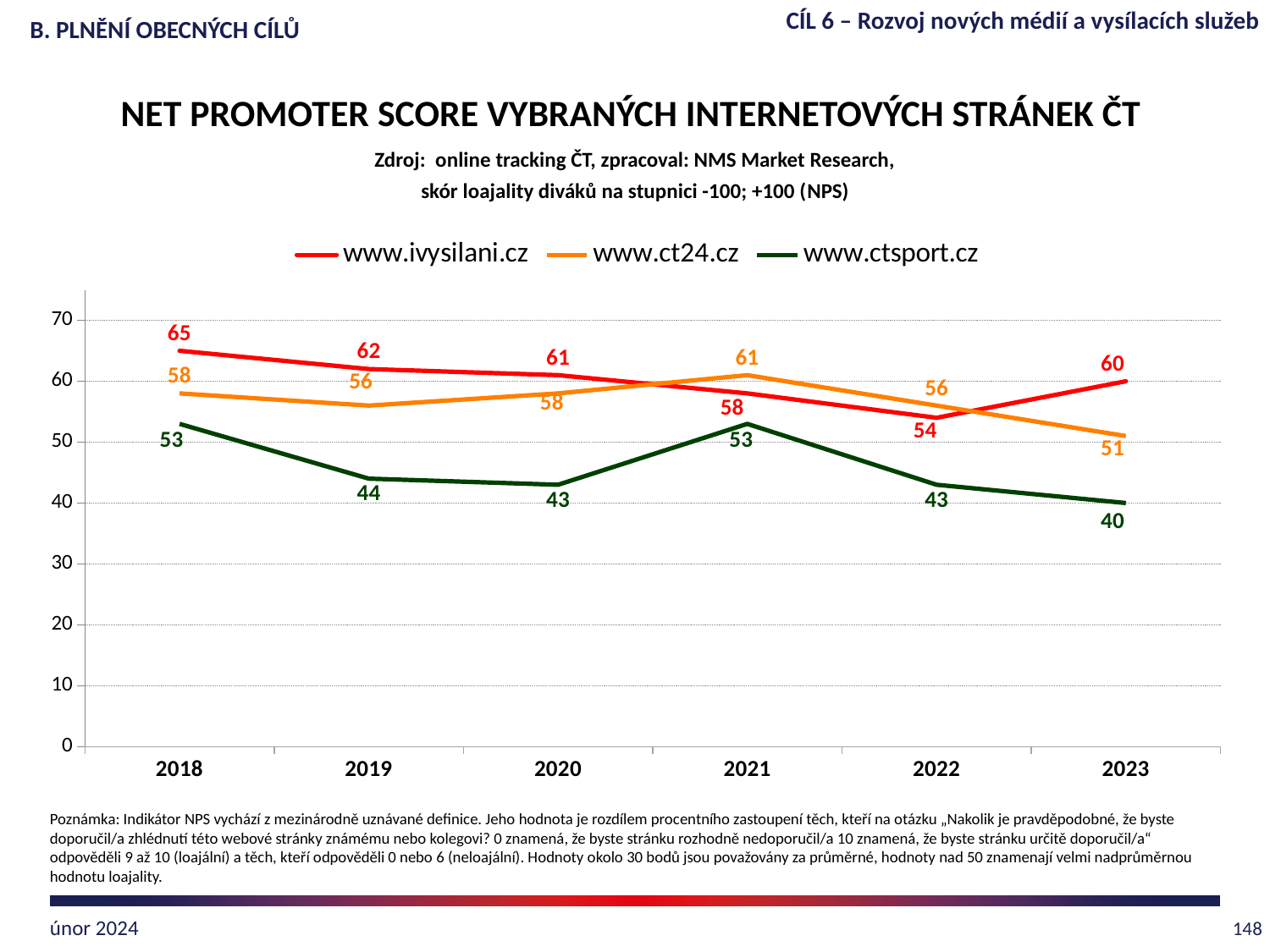
What is the NPS value for www.ct24.cz in 2021? 61 In which year does www.ivysilani.cz have its highest value? 2018 Does the value for www.ct24.cz rise or fall from 2021 to 2023? fall What is the difference between the www.ivysilani.cz value in 2018 and its value in 2022? 11 Which series is drawn in green? www.ctsport.cz How many series does the legend list? 3 How many years are shown on the x axis? 6 In which year does www.ctsport.cz have its lowest value? 2023 What is the NPS value for www.ctsport.cz in 2023? 40 Which is larger in 2022: the value for www.ct24.cz or the value for www.ivysilani.cz? www.ct24.cz What kind of chart is shown on the slide? line chart What is the NPS value for www.ivysilani.cz in 2018? 65